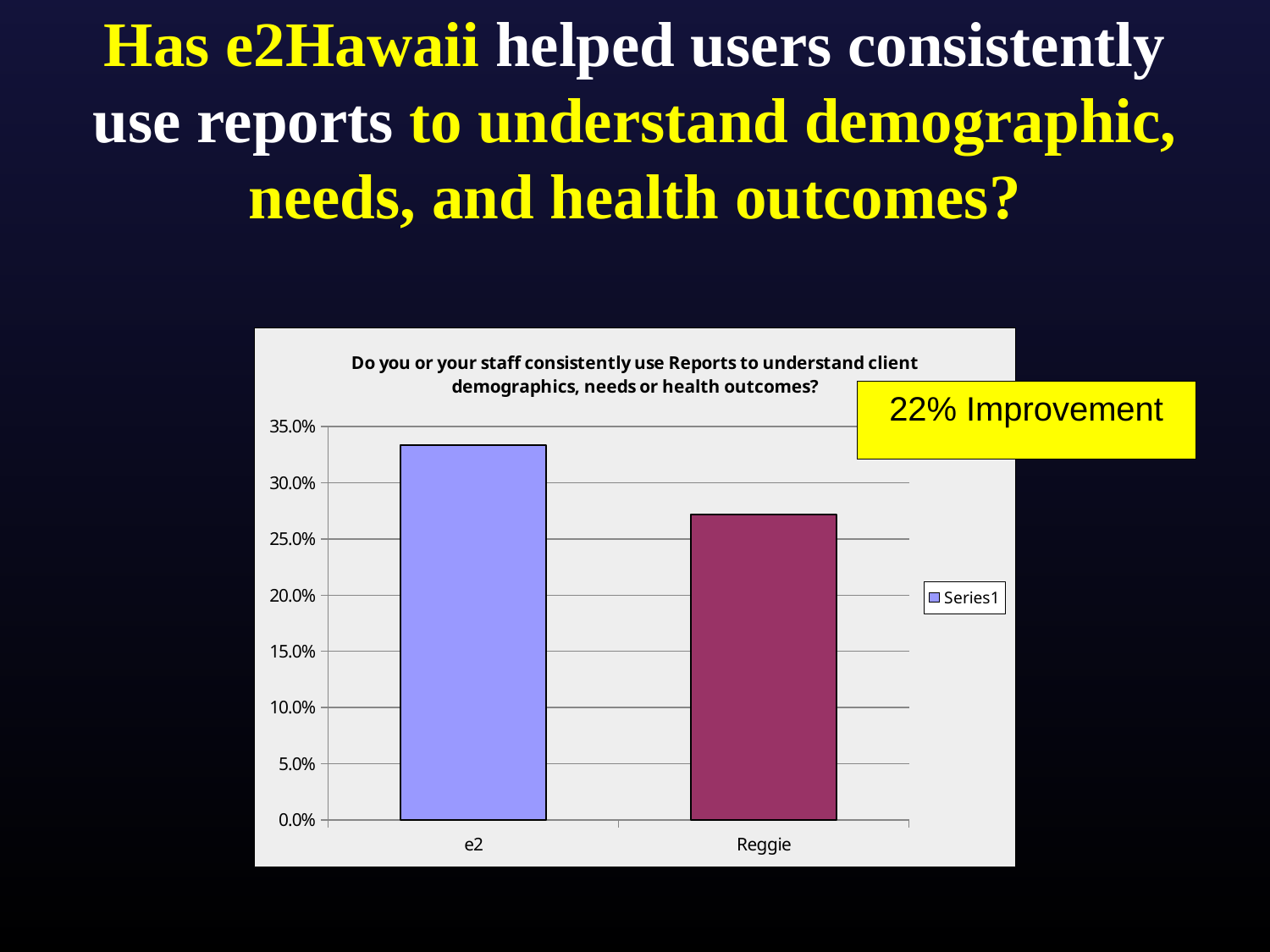
What is the name of the series shown in the legend? Series1 What is the highest value shown on the y axis? 35.0% Is the value for e2 larger or smaller than the value for Reggie? larger How many bars does the chart show? 2 Which category has the lowest value? Reggie Is the value for Reggie greater or less than 25.0%? greater Is the value for Reggie greater or less than 30.0%? less What improvement percentage is stated in the yellow box on the chart? 22% Improvement Which category has the highest value, e2 or Reggie? e2 What kind of chart is shown on the slide? bar chart How many series does the legend list? 1 Is the value for e2 greater or less than 30.0%? greater